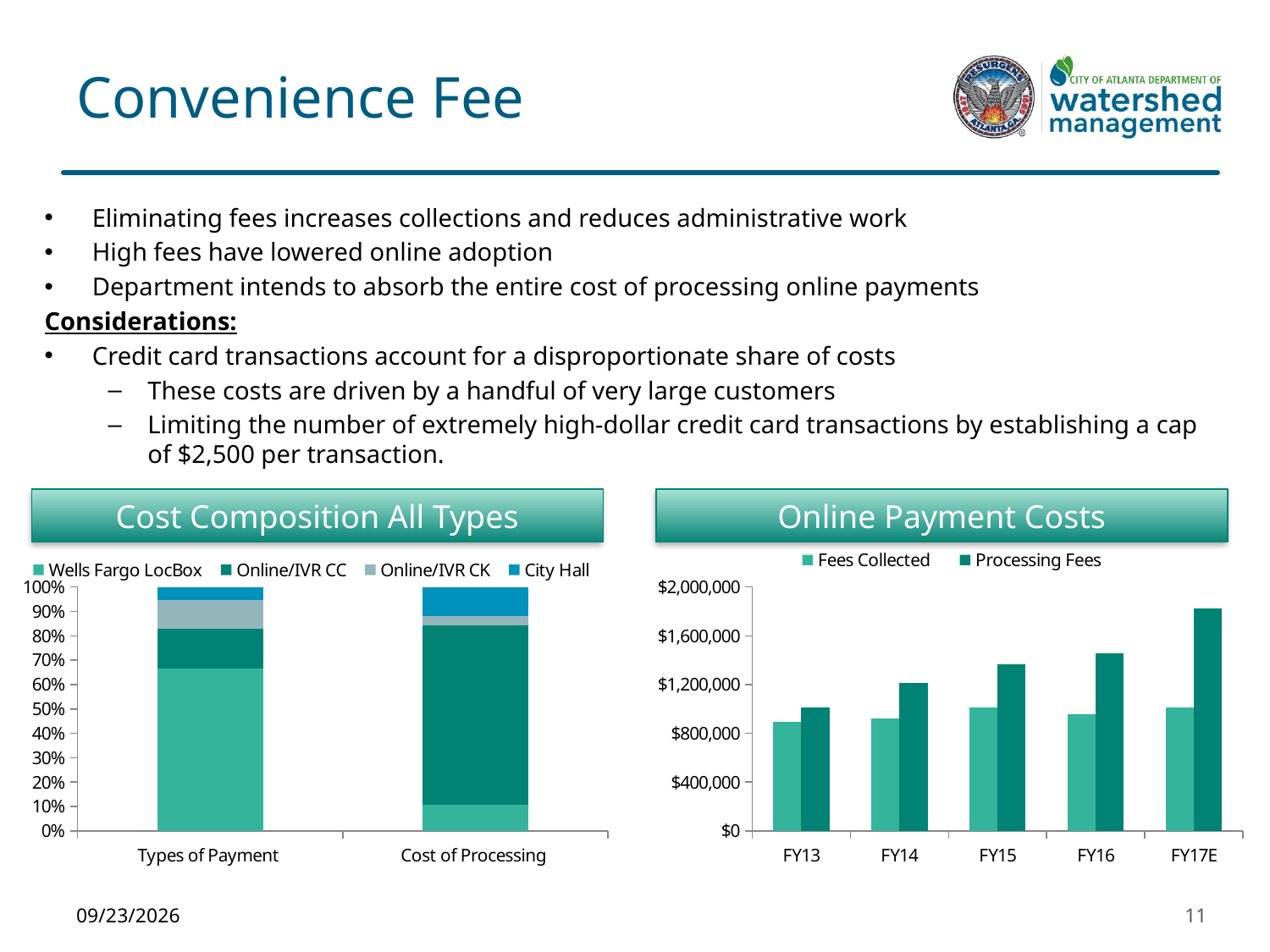
In the Cost Composition All Types chart, is the Wells Fargo LocBox share for Types of Payment greater or less than 50%? greater In the Online Payment Costs chart, which fiscal year has the highest Processing Fees? FY17E In the Online Payment Costs chart, how many fiscal years are shown on the x axis? 5 In the Online Payment Costs chart, are Processing Fees for FY17E greater or less than $1,600,000? greater What kind of chart is the Cost Composition All Types chart? Stacked bar chart In the Cost Composition All Types chart, how many categories are shown on the x axis? 2 In the Cost Composition All Types chart, how many series does the legend list? 4 In the Cost Composition All Types chart, which category has the larger Online/IVR CC share, Types of Payment or Cost of Processing? Cost of Processing In the Online Payment Costs chart, do Processing Fees rise or fall from FY13 to FY17E? rise In the Online Payment Costs chart, which series does the legend list besides Fees Collected? Processing Fees In the Cost Composition All Types chart, is the Wells Fargo LocBox share for Cost of Processing greater or less than 20%? less In the Online Payment Costs chart, which fiscal year has the lowest Processing Fees? FY13